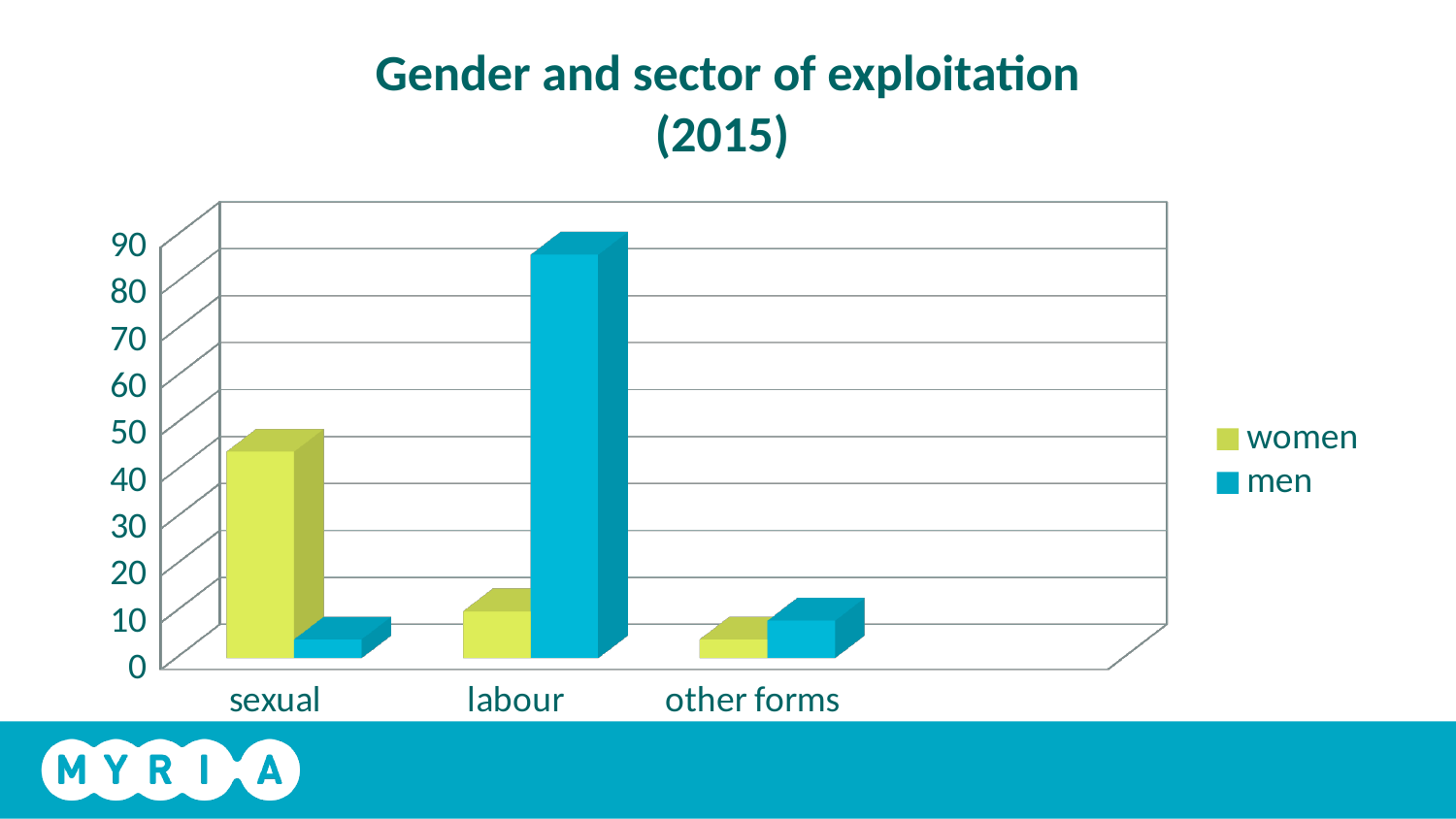
Which bar is the tallest in the whole chart? men, labour Which category has the highest bar for women? sexual How many series does the legend list? 2 What kind of chart is shown on the slide? bar chart Is the value for men in the labour category greater or less than 70? greater Is the value for women in the sexual category greater or less than 30? greater In the labour category, which is larger, the value for women or for men? men In the sexual category, which is larger, the value for women or for men? women Which category has the highest bar for men? labour What is the title of the chart? Gender and sector of exploitation (2015) How many sector categories are shown on the x axis? 3 Is the value for women in the labour category greater or less than 20? less